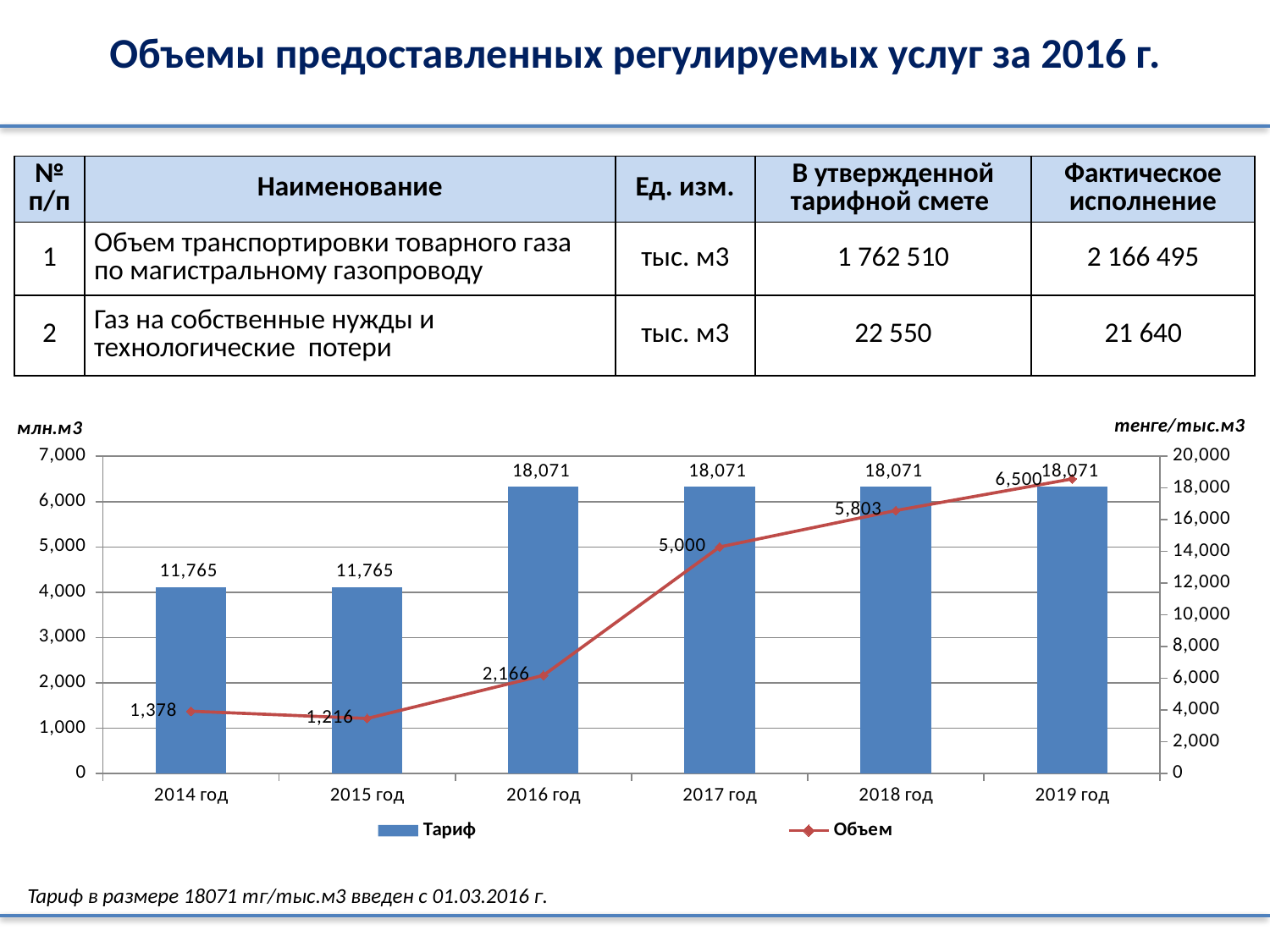
In which year is Объем lowest? 2015 год How many years are shown on the x axis of the chart? 6 What is the difference between Тариф in 2016 год and Тариф in 2015 год? 6,306 In which year is Объем highest? 2019 год What is the value of Тариф for 2018 год? 18,071 What is the value of Тариф for 2014 год? 11,765 What is the difference between Объем in 2019 год and Объем in 2018 год? 697 Which is larger: Объем in 2014 год or Объем in 2015 год? 2014 год How many series does the chart legend list? 2 What is the value of Объем for 2019 год? 6,500 Does Объем rise or fall from 2015 год to 2019 год? rise What is the value of Объем for 2017 год? 5,000